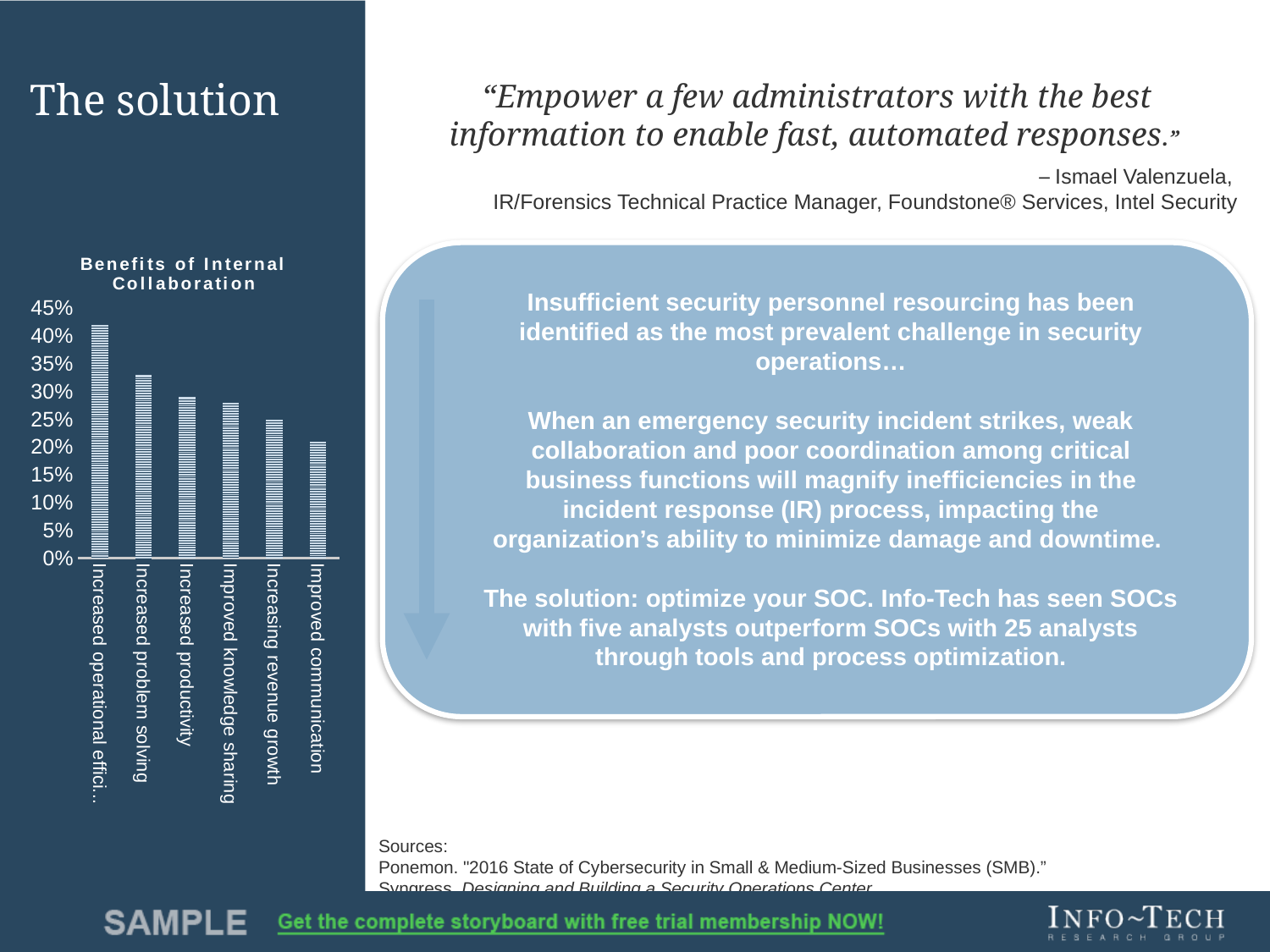
In the "Benefits of Internal Collaboration" chart, is the value for Increasing revenue growth greater or less than 20%? greater In the "Benefits of Internal Collaboration" chart, is the value for Improved communication greater or less than 25%? less In the "Benefits of Internal Collaboration" chart, is the value for Increased problem solving greater or less than 30%? greater What is the title of the chart on the left side of the slide? Benefits of Internal Collaboration How many categories are plotted in the "Benefits of Internal Collaboration" chart? 6 What is the highest tick value shown on the vertical axis of the "Benefits of Internal Collaboration" chart? 45% What kind of chart is shown under the title "Benefits of Internal Collaboration"? bar chart In the "Benefits of Internal Collaboration" chart, which is larger: Increased problem solving or Improved communication? Increased problem solving Which category has the highest value in the "Benefits of Internal Collaboration" chart? Increased operational effici... Do the values in the "Benefits of Internal Collaboration" chart rise or fall from left to right? fall Which category has the lowest value in the "Benefits of Internal Collaboration" chart? Improved communication